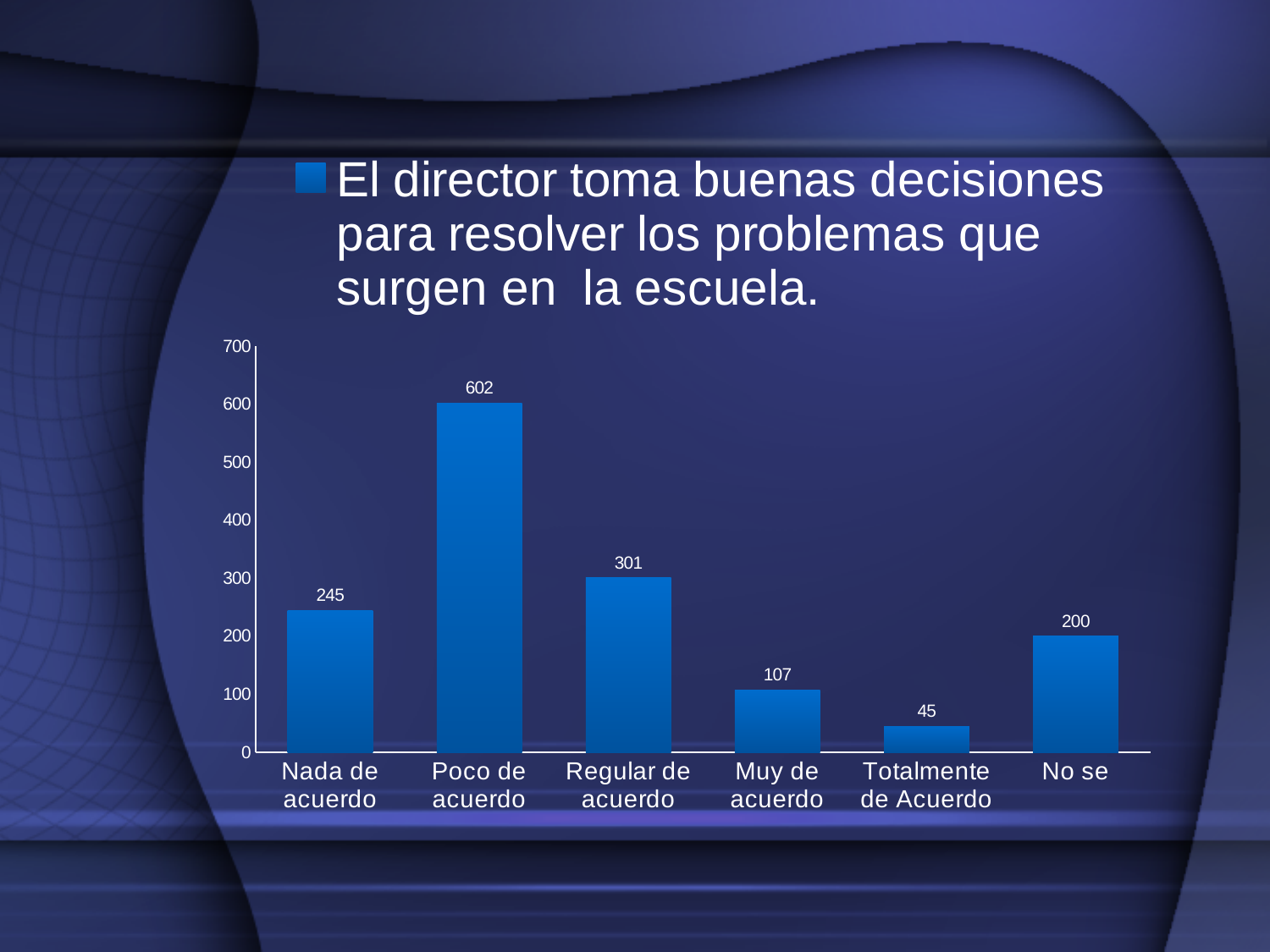
Which category has the lowest value? Totalmente de Acuerdo Is the value for "Regular de acuerdo" greater or less than 400? less What is the value for "Poco de acuerdo"? 602 What is the highest value shown on the vertical axis? 700 Which category has the highest value? Poco de acuerdo What is the difference between the values for "Nada de acuerdo" and "No se"? 45 What is the difference between the values for "Poco de acuerdo" and "Regular de acuerdo"? 301 How many categories are shown on the x axis? 6 Which is larger, the value for "Muy de acuerdo" or the value for "No se"? No se What is the value for "Totalmente de Acuerdo"? 45 What kind of chart is shown on the slide? bar chart What is the value for "No se"? 200